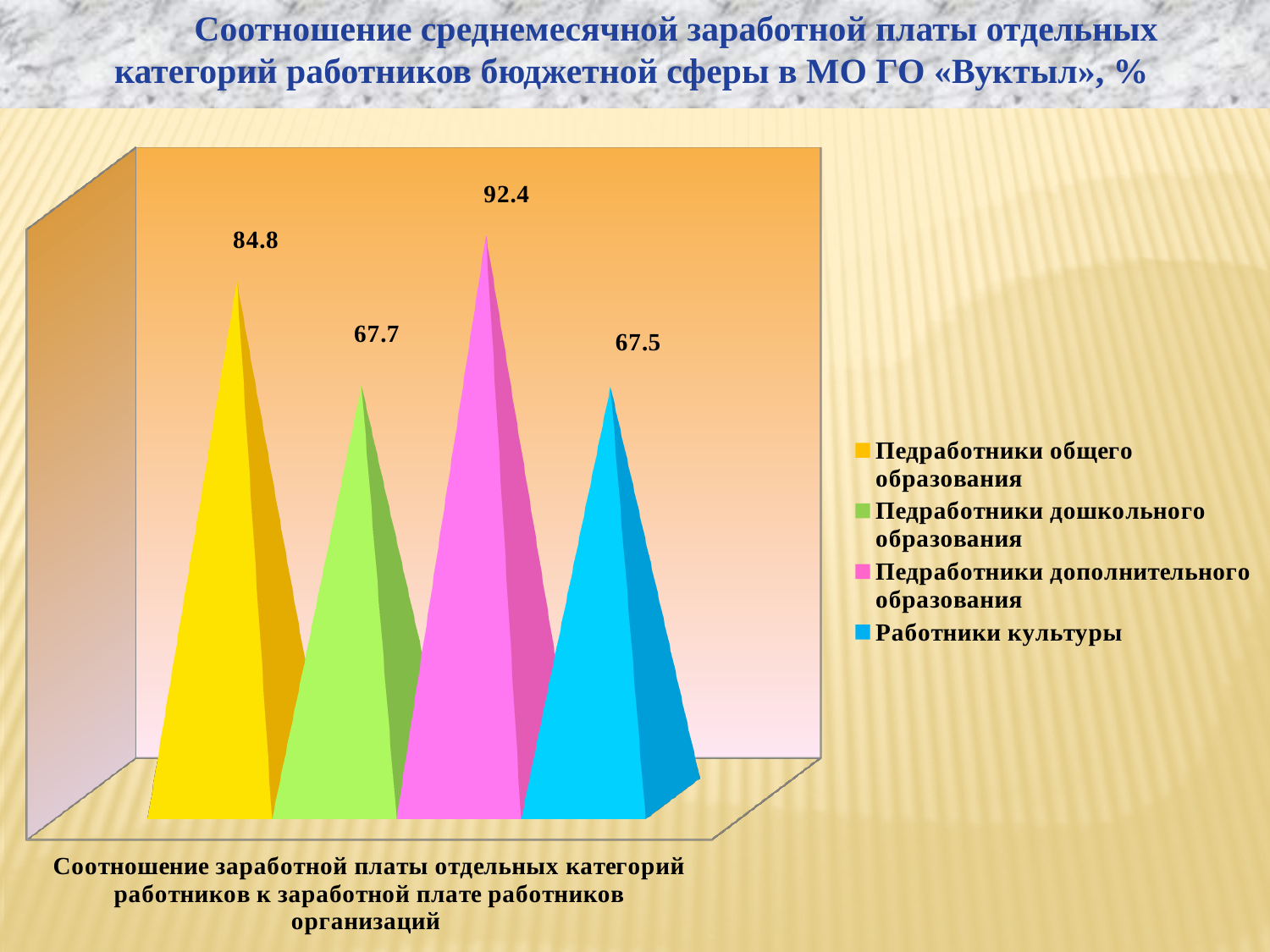
What kind of chart is shown on the slide? Bar chart How many series does the legend list? 4 What is the value for Педработники общего образования? 84.8 Which is larger: the value for Педработники общего образования or the value for Педработники дошкольного образования? Педработники общего образования What is the difference between the values for Педработники общего образования and Работники культуры? 17.3 Which series has the lowest value? Работники культуры What is the value for Педработники дополнительного образования? 92.4 What is the value for Работники культуры? 67.5 Which series has the highest value? Педработники дополнительного образования What is the difference between the values for Педработники дополнительного образования and Педработники общего образования? 7.6 What is the value for Педработники дошкольного образования? 67.7 What colour represents Работники культуры in the chart? Blue